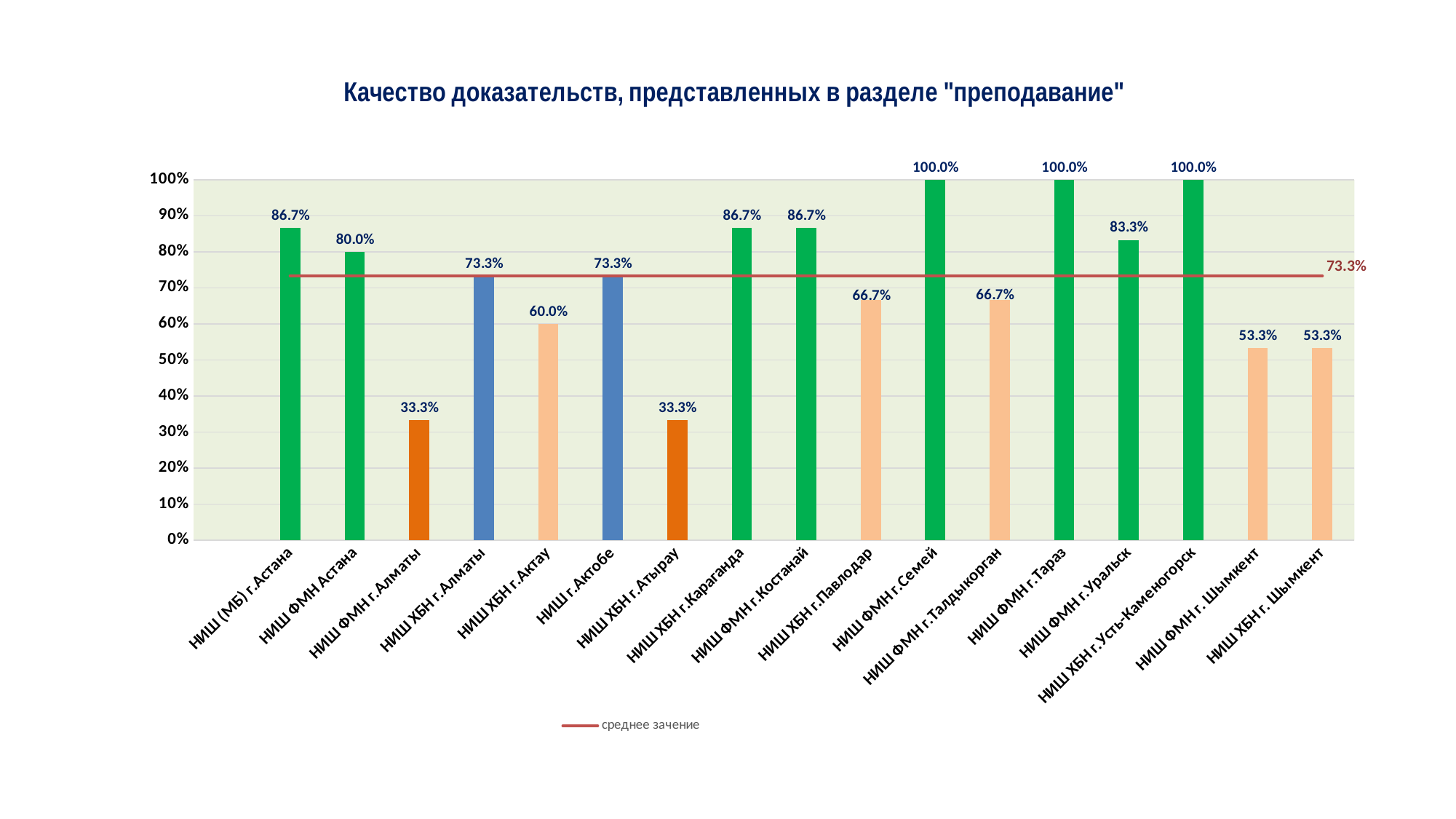
What value does the average line (среднее зачение) show? 73.3% What kind of chart is shown on the slide? combination bar and line chart (bars with an average line) What is the title of the chart? Качество доказательств, представленных в разделе "преподавание" What is the value for НИШ ФМН г.Уральск? 83.3% What is the value for НИШ ХБН г.Павлодар? 66.7% Which schools have the highest value on the chart? НИШ ФМН г.Семей, НИШ ФМН г.Тараз, НИШ ХБН г.Усть-Каменогорск Which is larger, the value for НИШ ФМН Астана or the value for НИШ ФМН г.Уральск? НИШ ФМН г.Уральск What is the difference between the values for НИШ ФМН г.Уральск and НИШ ХБН г.Актау? 23.3 percentage points Which schools have the lowest value on the chart? НИШ ФМН г.Алматы, НИШ ХБН г.Атырау What is the value for НИШ ХБН г.Актау? 60.0% How many schools (categories) are shown on the x axis? 17 Is the value for НИШ ФМН г.Шымкент greater or less than 60%? less